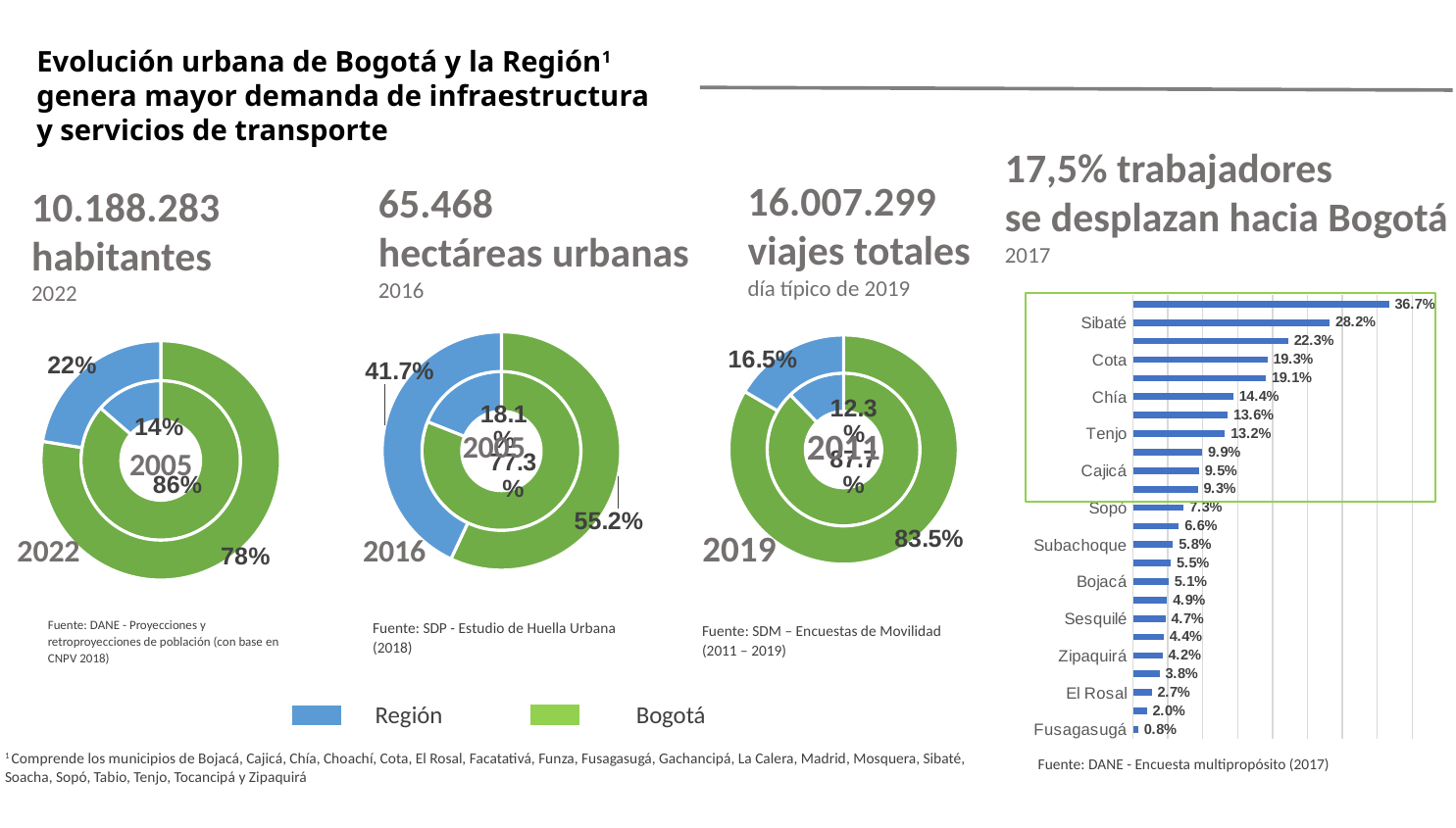
In the '65.468 hectáreas urbanas' donut chart, what share does Región have in 2016? 41.7% In the '10.188.283 habitantes' donut chart, by how many percentage points did Región's share grow from 2005 to 2022? 8 percentage points In the '17,5% trabajadores se desplazan hacia Bogotá' chart, what is the value for Sibaté? 28.2% In the '17,5% trabajadores se desplazan hacia Bogotá' chart, what is the difference between Cota and Chía? 4.9 percentage points What type of chart is the '17,5% trabajadores se desplazan hacia Bogotá' chart? Bar chart In the '17,5% trabajadores se desplazan hacia Bogotá' chart, what is the value for Cajicá? 9.5% In the '10.188.283 habitantes' donut chart, what share does Bogotá have in 2005? 86% In the '65.468 hectáreas urbanas' donut chart, what share does Bogotá have in 2005? 77.3% In the '17,5% trabajadores se desplazan hacia Bogotá' chart, which labelled municipality has the lowest value? Fusagasugá In the '16.007.299 viajes totales' donut chart, what share does Región have in 2019? 16.5% In the '16.007.299 viajes totales' donut chart, which is larger in 2011, Región or Bogotá? Bogotá In the '10.188.283 habitantes' donut chart, what share does Región have in 2022? 22%